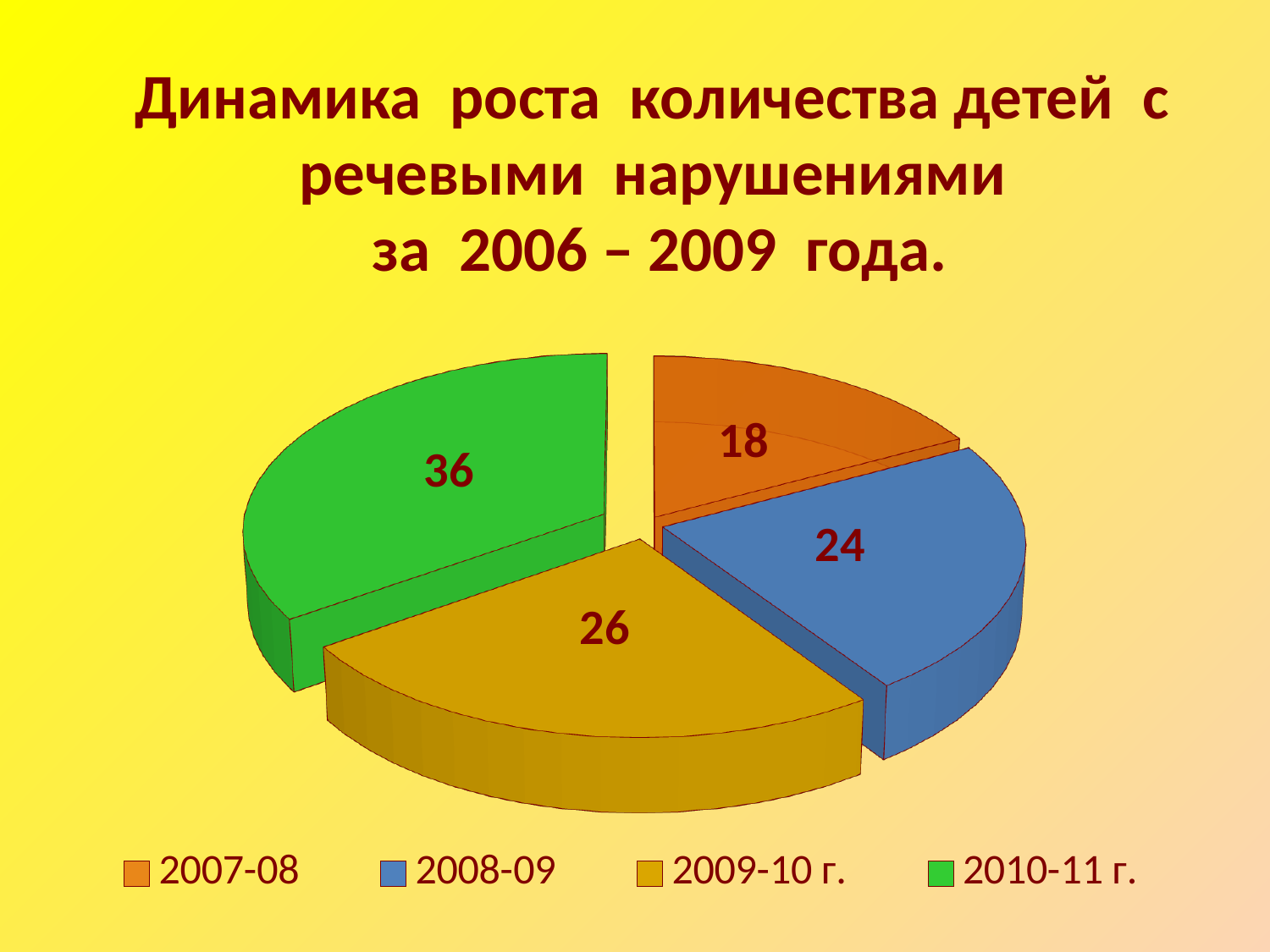
What value is shown for the 2009-10 г. slice? 26 What value is shown for the 2007-08 slice? 18 Which is larger, the value for 2008-09 or the value for 2009-10 г.? 2009-10 г. What share of the pie does the 2009-10 г. slice represent? 25% What kind of chart is shown on the slide? pie chart Which category has the smallest slice? 2007-08 What is the difference between the values for 2010-11 г. and 2007-08? 18 Which category has the largest slice? 2010-11 г. What colour is the 2010-11 г. slice? green How many slices does the pie chart have? 4 What value is shown for the 2008-09 slice? 24 What value is shown for the 2010-11 г. slice? 36